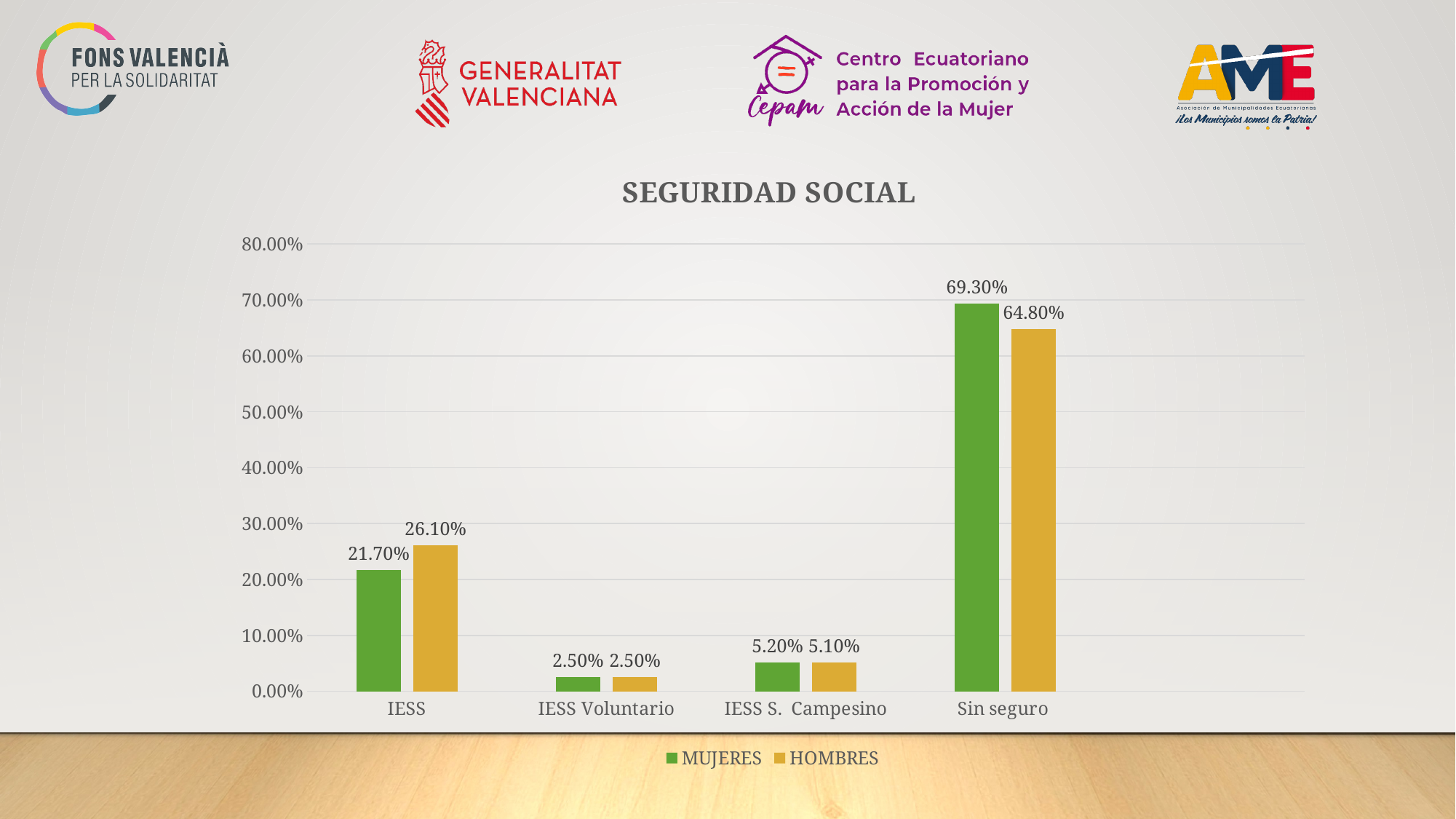
Is the value for MUJERES in the Sin seguro category greater or less than 60.00%? greater Which category has the highest value for MUJERES? Sin seguro In the IESS category, which series has the larger value, MUJERES or HOMBRES? HOMBRES What is the difference between the HOMBRES and MUJERES values in the IESS category? 4.40% How many series does the legend list? 2 What is the difference between the MUJERES and HOMBRES values in the Sin seguro category? 4.50% Which category has the lowest value for HOMBRES? IESS Voluntario What type of chart is shown on the slide? bar chart How many categories are shown on the x axis? 4 What is the value for HOMBRES in the Sin seguro category? 64.80% What is the value for MUJERES in the IESS category? 21.70% What is the value for HOMBRES in the IESS S. Campesino category? 5.10%